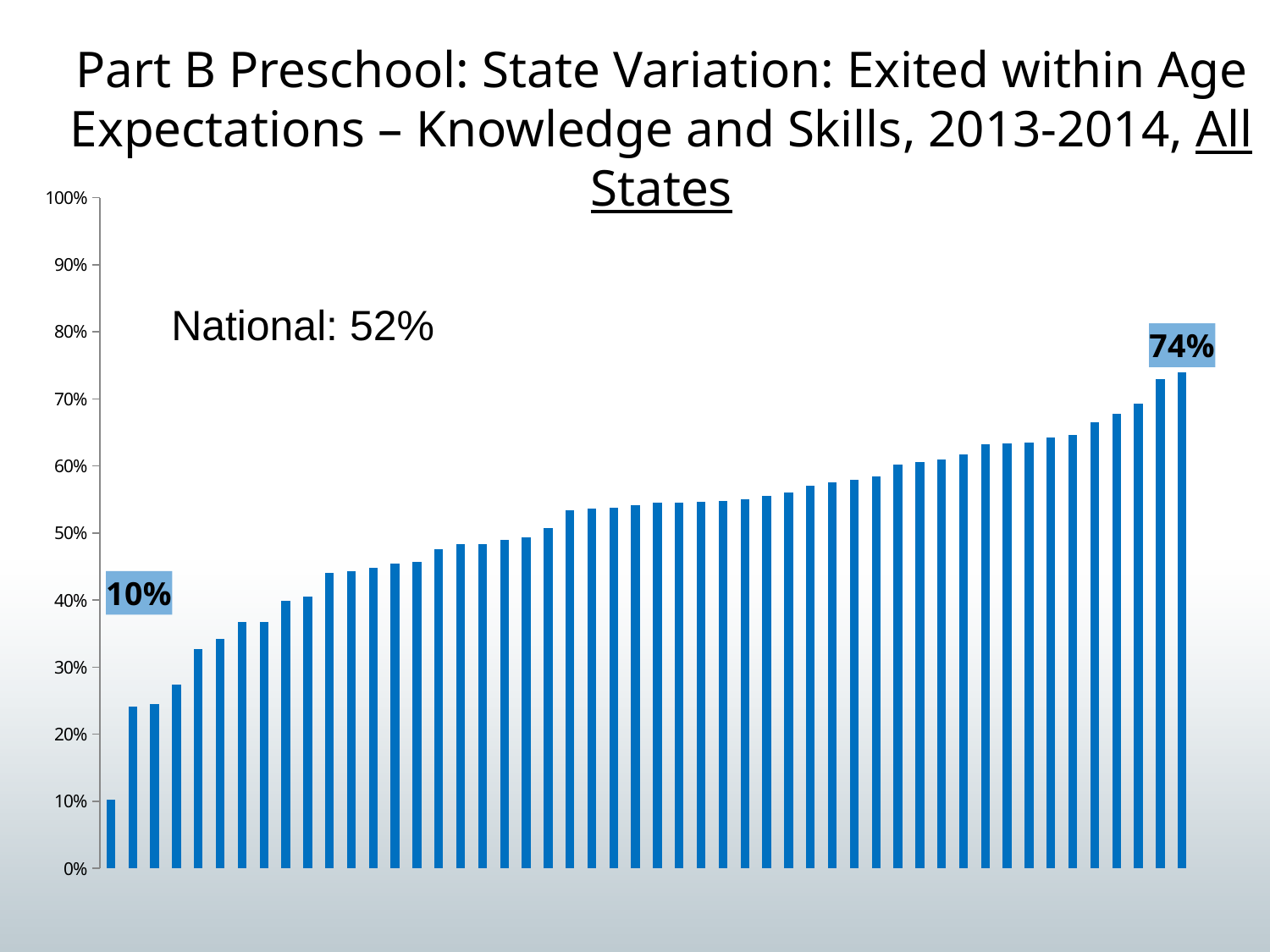
What is the highest value shown on the vertical axis? 100% What kind of chart is shown on the slide? bar chart Which bar is larger, the leftmost bar or the rightmost bar? the rightmost bar What national value is printed on the chart? 52% Do the bar values rise or fall from left to right across the chart? rise Is the value of the rightmost bar greater or less than 70%? greater What is the value of the highest bar in the chart? 74% What is the value of the lowest bar in the chart? 10% Which school year does the chart title say the data covers? 2013-2014 Is the national value of 52% greater or less than the highest state bar of 74%? less What is the difference between the highest bar (74%) and the lowest bar (10%)? 64 percentage points Is the value of the leftmost bar greater or less than 20%? less